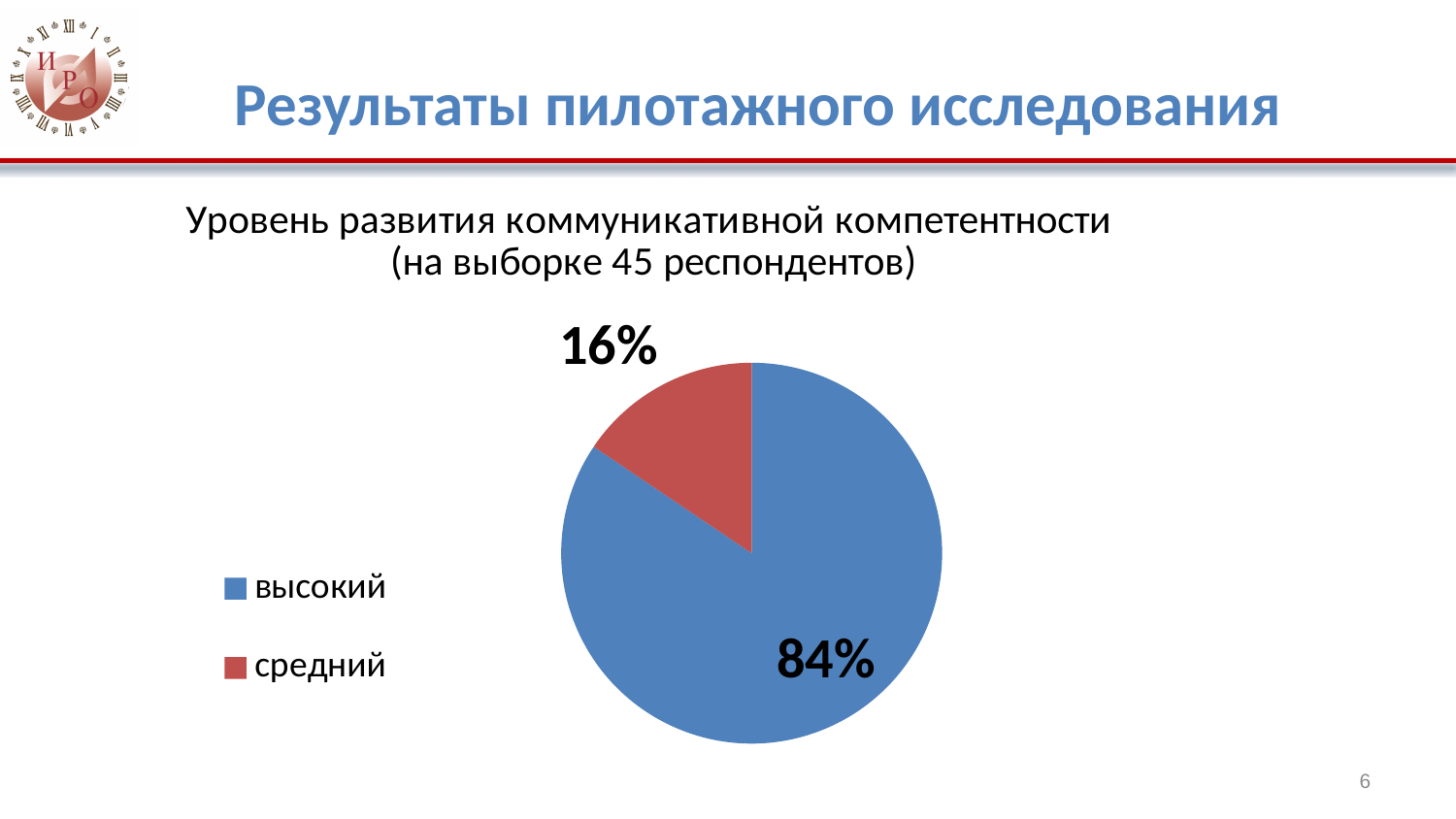
How many slices does the pie chart have? 2 Which category has the smallest slice of the pie? средний How many respondents were in the sample according to the chart title? 45 Which is larger, the "высокий" slice or the "средний" slice? высокий What is the difference in percentage points between the "высокий" and "средний" slices? 68 How many entries does the legend list? 2 What kind of chart is shown on the slide? pie chart What share of the pie does the "средний" slice represent? 16% Which category has the largest slice of the pie? высокий What colour is the "средний" slice? red What share of the pie does the "высокий" slice represent? 84%